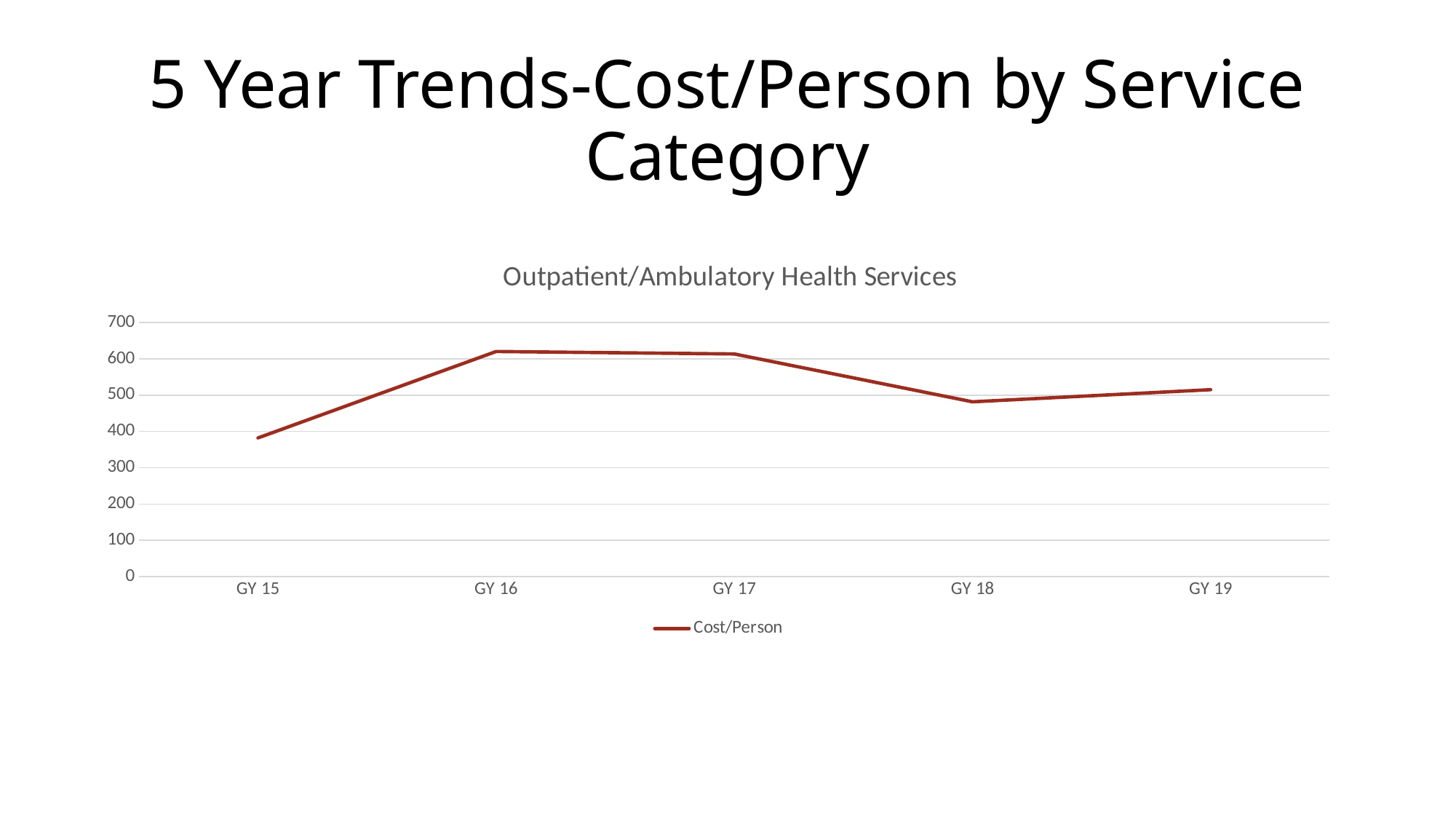
How many series does the legend list? 1 Which is larger, the Cost/Person for GY 16 or for GY 15? GY 16 Is the Cost/Person for GY 15 greater or less than 400? less Which is larger, the Cost/Person for GY 17 or for GY 18? GY 17 Is the Cost/Person for GY 18 greater or less than 500? less What kind of chart is shown on the slide? line chart What is the name of the series shown in the legend? Cost/Person Does the Cost/Person rise or fall from GY 17 to GY 18? fall How many years are plotted along the x axis? 5 Which year has the lowest Cost/Person? GY 15 What is the title of the chart? Outpatient/Ambulatory Health Services Is the Cost/Person for GY 16 greater or less than 600? greater